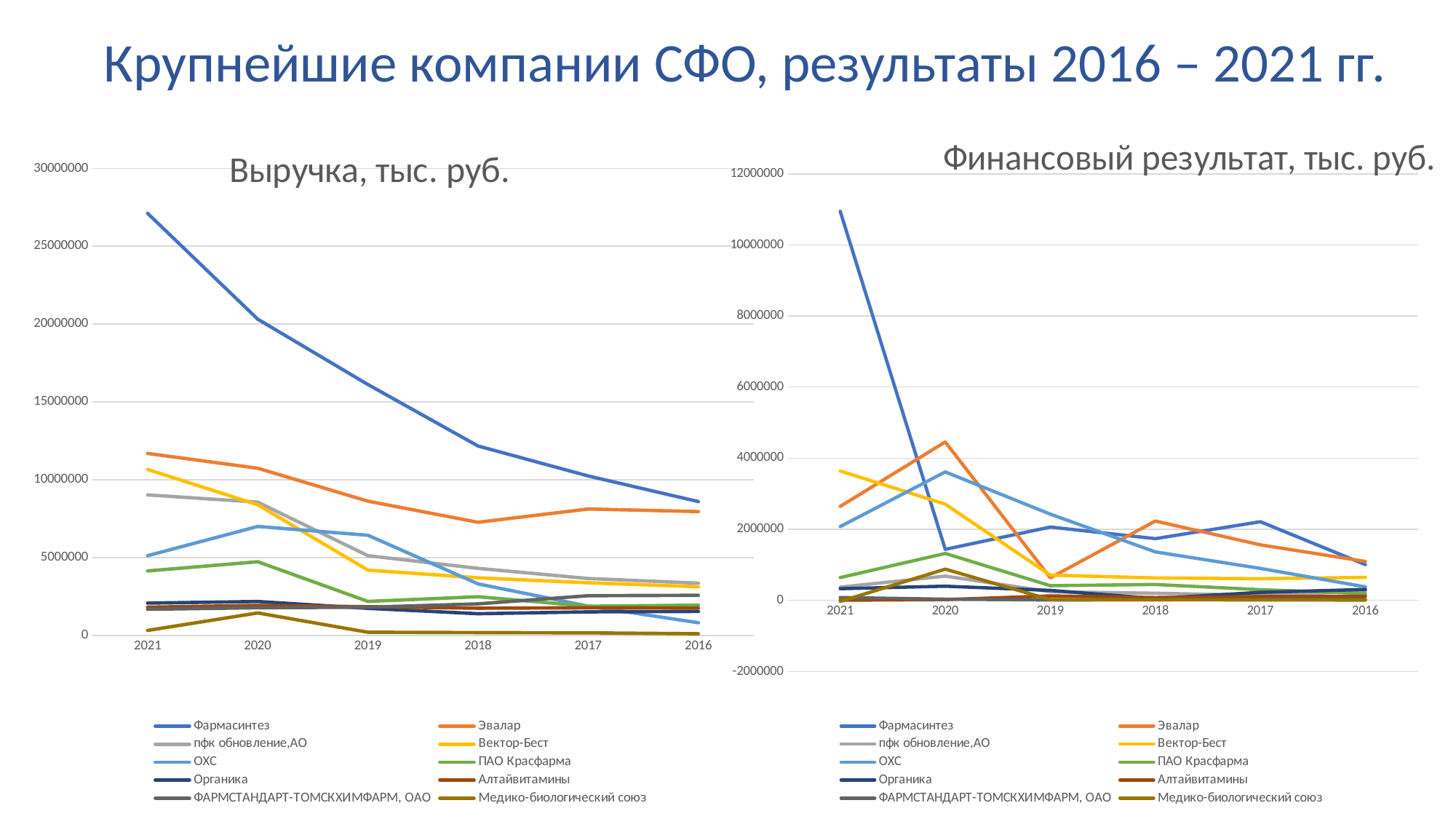
In the left chart "Выручка, тыс. руб.", which company has the lowest revenue in 2021? Медико-биологический союз How many series does the legend of the right chart "Финансовый результат, тыс. руб." list? 10 In the left chart "Выручка, тыс. руб.", does the Фармасинтез line rise or fall moving left to right along the x axis from 2021 to 2016? fall In the left chart "Выручка, тыс. руб.", is the value for Фармасинтез in 2021 greater or less than 25000000? greater In the left chart "Выручка, тыс. руб.", is the value for Фармасинтез in 2016 greater or less than 10000000? less What kind of chart is the left chart titled "Выручка, тыс. руб."? line chart In the left chart "Выручка, тыс. руб.", which company has the highest revenue in 2021? Фармасинтез In the right chart "Финансовый результат, тыс. руб.", which company has the highest financial result in 2021? Фармасинтез In the right chart "Финансовый результат, тыс. руб.", which company has the highest financial result in 2020? Эвалар How many years are shown on the x axis of the left chart "Выручка, тыс. руб."? 6 In the left chart "Выручка, тыс. руб.", which is larger in 2021: the revenue of Эвалар or of Вектор-Бест? Эвалар In the right chart "Финансовый результат, тыс. руб.", is the value for Фармасинтез in 2021 greater or less than 10000000? greater